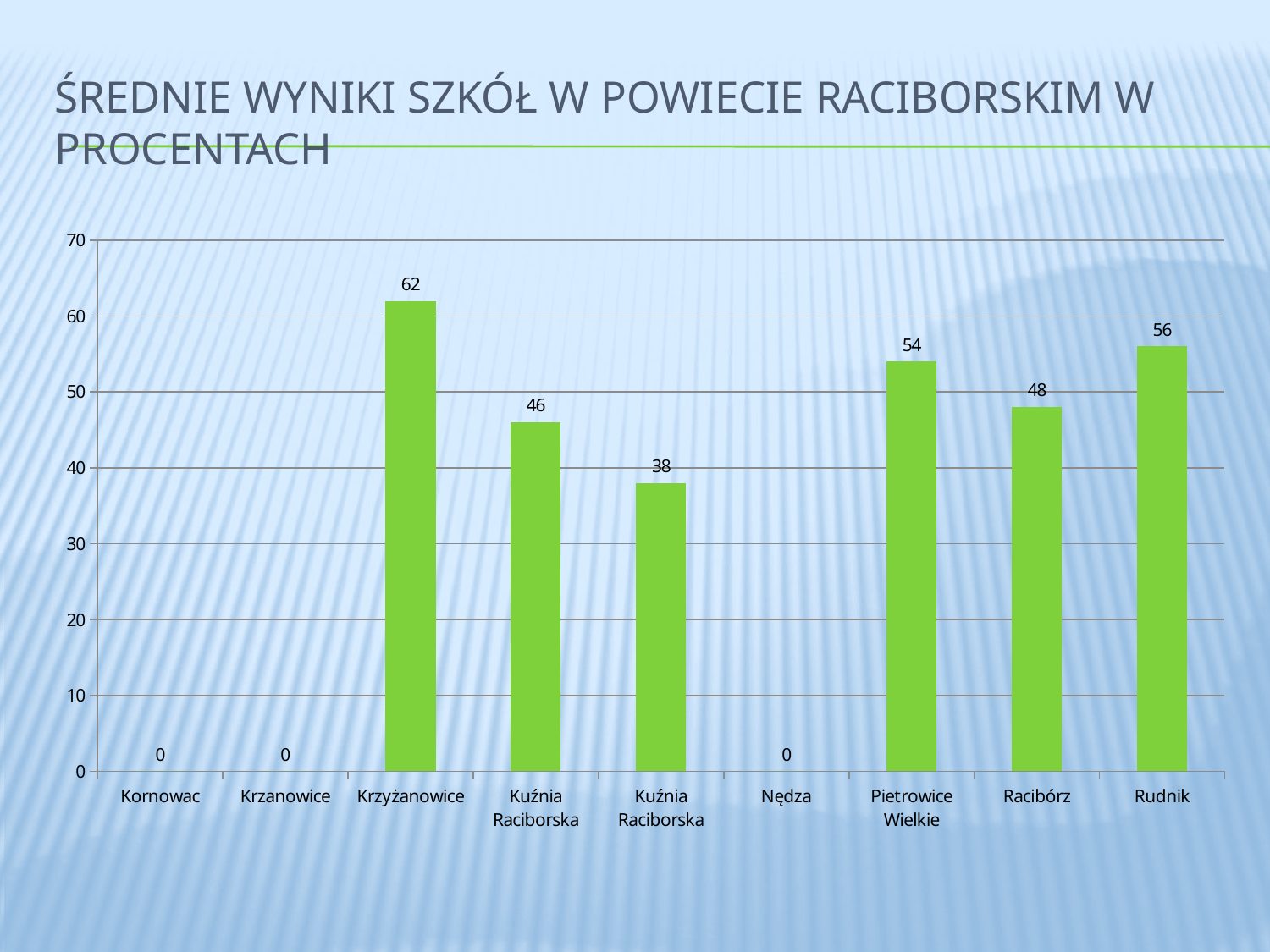
What kind of chart is shown on the slide? bar chart What is the value for Pietrowice Wielkie? 54 What is the value for Rudnik? 56 Which category has the highest value? Krzyżanowice What is the difference between the values for Krzyżanowice and Rudnik? 6 What is the value for Nędza? 0 What is the value for Krzyżanowice? 62 How many categories are shown on the x axis? 9 What is the value for Racibórz? 48 Which is larger, the value for Rudnik or the value for Pietrowice Wielkie? Rudnik What is the difference between the values for Pietrowice Wielkie and Racibórz? 6 Is the value for Racibórz greater or less than 50? less